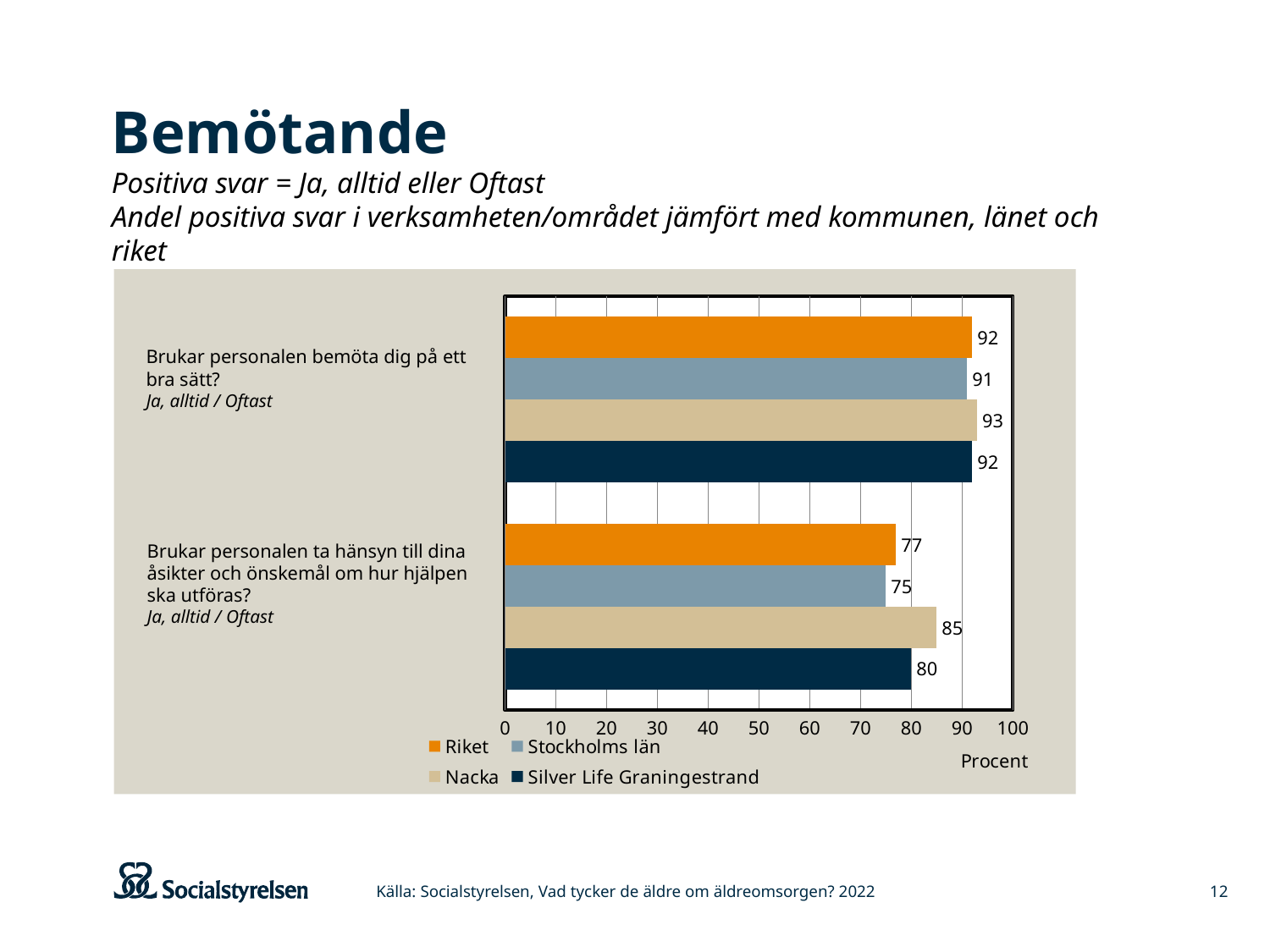
Which series has the lowest value on the question "Brukar personalen bemöta dig på ett bra sätt?"? Stockholms län How many series does the legend list? 4 What is the value for Silver Life Graningestrand on the question "Brukar personalen ta hänsyn till dina åsikter och önskemål om hur hjälpen ska utföras?"? 80 What unit is shown on the x axis of the chart? Procent How many question categories are plotted in the chart? 2 What type of chart is shown on the slide? bar chart Which series has the highest value on the question "Brukar personalen ta hänsyn till dina åsikter och önskemål om hur hjälpen ska utföras?"? Nacka Which is larger on the question "Brukar personalen ta hänsyn till dina åsikter och önskemål om hur hjälpen ska utföras?": Riket or Silver Life Graningestrand? Silver Life Graningestrand What is the value for Stockholms län on the question "Brukar personalen ta hänsyn till dina åsikter och önskemål om hur hjälpen ska utföras?"? 75 Is the value for Riket on the question "Brukar personalen ta hänsyn till dina åsikter och önskemål om hur hjälpen ska utföras?" greater or less than 80? less What is the value for Nacka on the question "Brukar personalen bemöta dig på ett bra sätt?"? 93 What is the difference between Nacka and Stockholms län on the question "Brukar personalen ta hänsyn till dina åsikter och önskemål om hur hjälpen ska utföras?"? 10